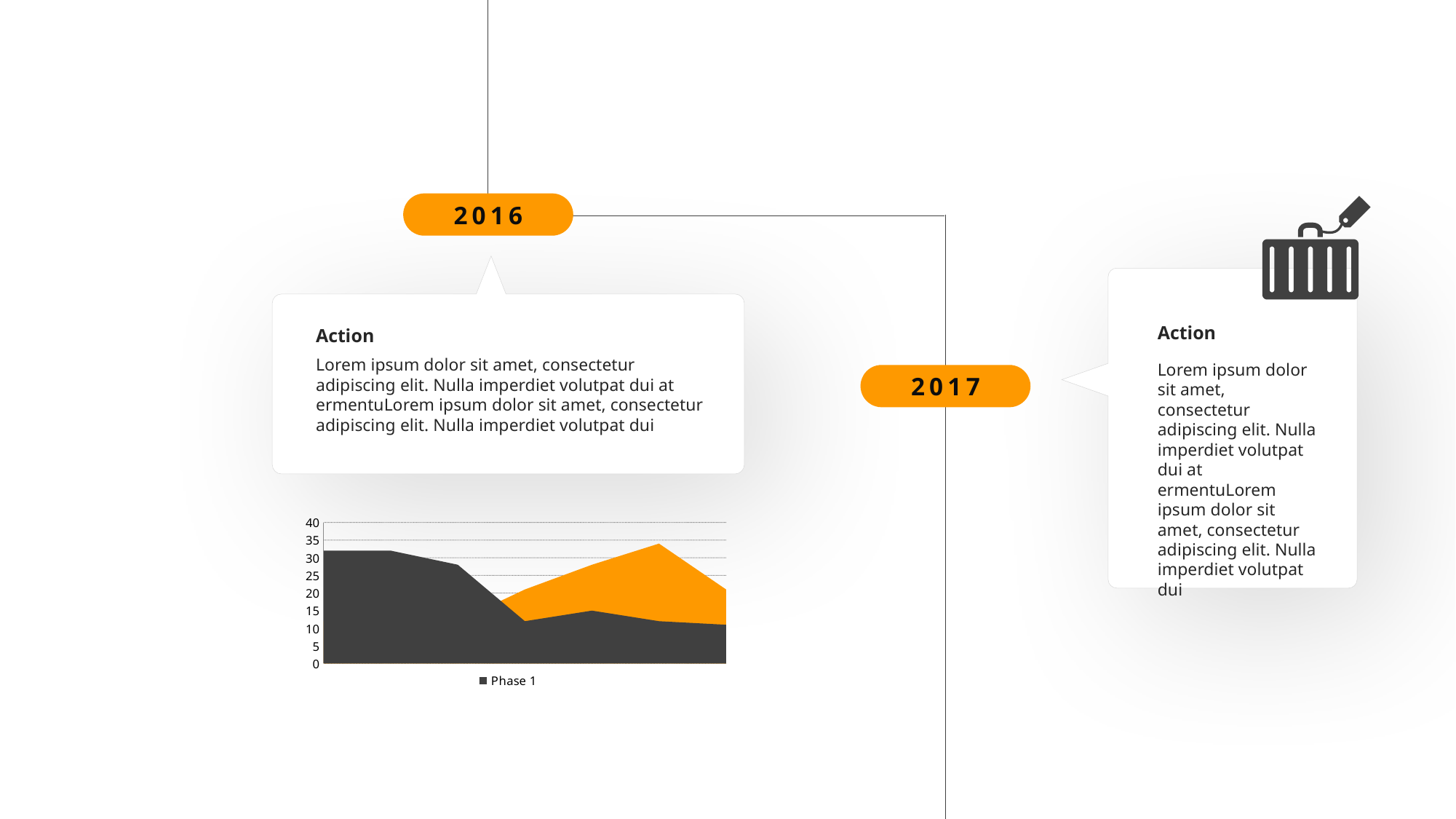
At the right end of the chart, which series is higher, the orange one or the dark grey one? orange Is the value of the dark grey series at the right end of the chart greater or less than 15? less Does the dark grey series rise or fall overall from left to right? falls Is the value of the dark grey series at the left end of the chart greater or less than 25? greater Is the lowest value of the dark grey series greater or less than 15? less What is the name of the series listed in the chart's legend? Phase 1 What kind of chart is shown on the slide? area chart How many series does the chart's legend list? 1 What is the highest value shown on the chart's vertical axis? 40